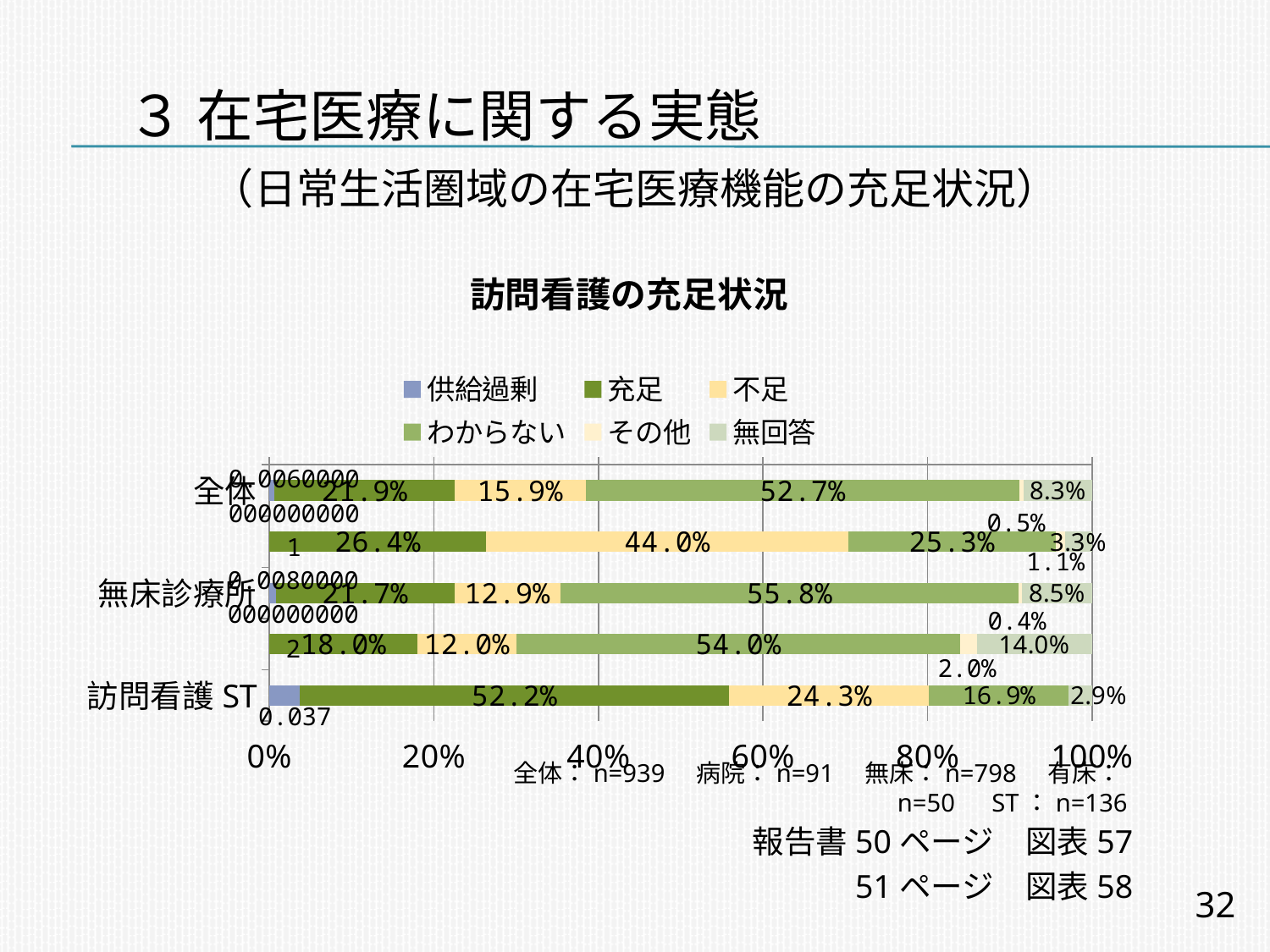
What is the わからない value for 全体? 52.7% Among 全体, 無床診療所 and 訪問看護ST, which has the lowest わからない value? 訪問看護ST Which has the larger 充足 value, 全体 or 訪問看護ST? 訪問看護ST What is the 充足 value for 訪問看護ST? 52.2% What is the 不足 value for 訪問看護ST? 24.3% How many series does the legend of the chart list? 6 What is the difference between the 不足 values for 全体 and 無床診療所? 3.0 percentage points What kind of chart is shown on the slide? Stacked bar chart What is the title of the chart? 訪問看護の充足状況 What is the 無回答 value for 無床診療所? 8.5% What is the 不足 value for 無床診療所? 12.9% What is the difference between the わからない values for 無床診療所 and 全体? 3.1 percentage points